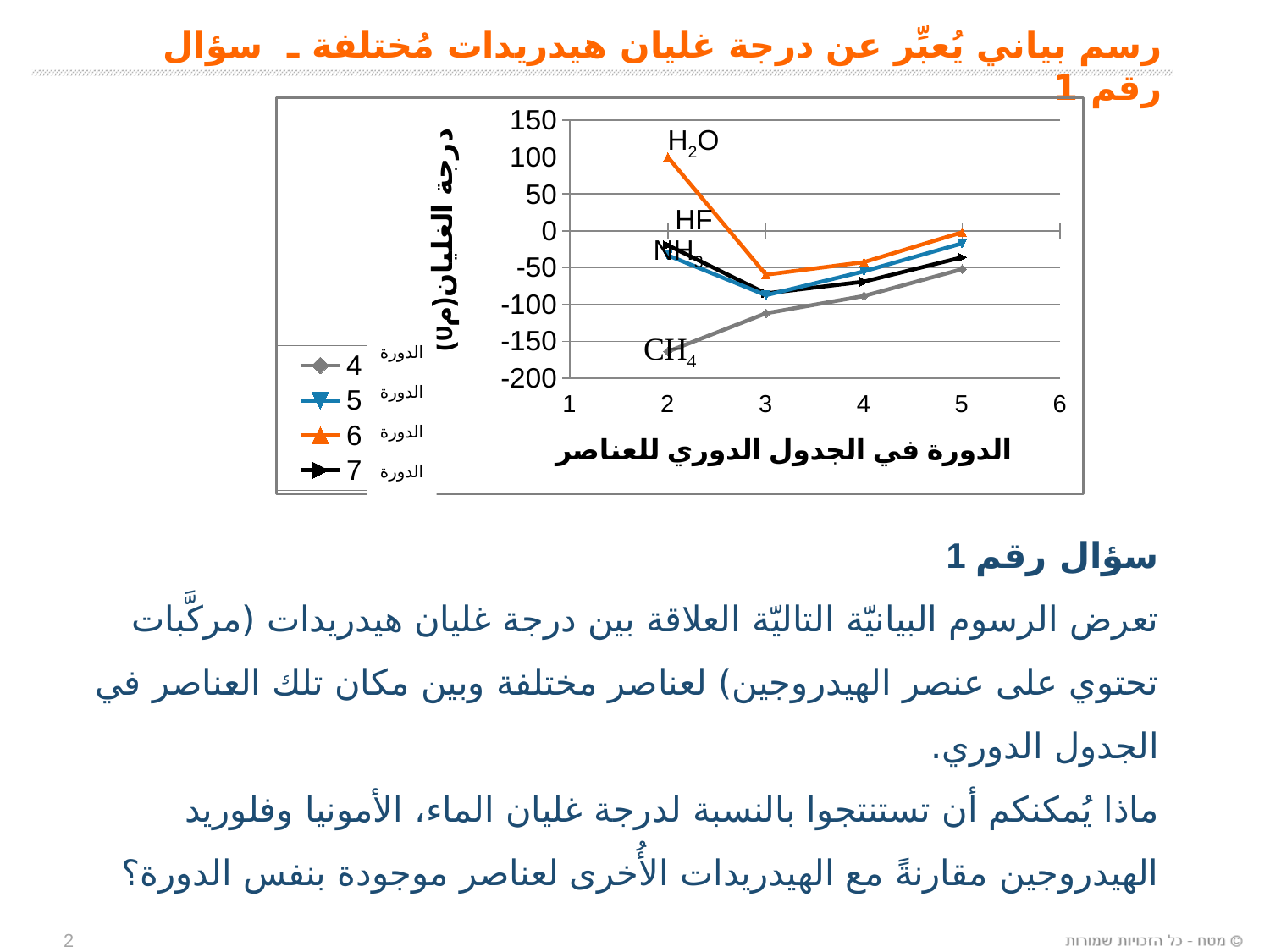
Which series has the highest value at x = 2? الدورة 6 Is the value for the point labelled H2O greater or less than 50? greater What is the title of the x axis? الدورة في الجدول الدوري للعناصر Is the value for the point labelled CH4 greater or less than -100? less How many series does the legend list? 4 Which series has the lowest value at x = 2? الدورة 4 Do the values of the series الدورة 4 rise or fall from x = 2 to x = 5? rise What are the legend entries of the chart? الدورة 4, الدورة 5, الدورة 6, الدورة 7 At x = 5, which series has the larger value, الدورة 6 or الدورة 4? الدورة 6 What is the boiling point value labelled H2O on the chart? 100 How many data points does each series have? 4 What kind of chart is shown on the slide? line chart